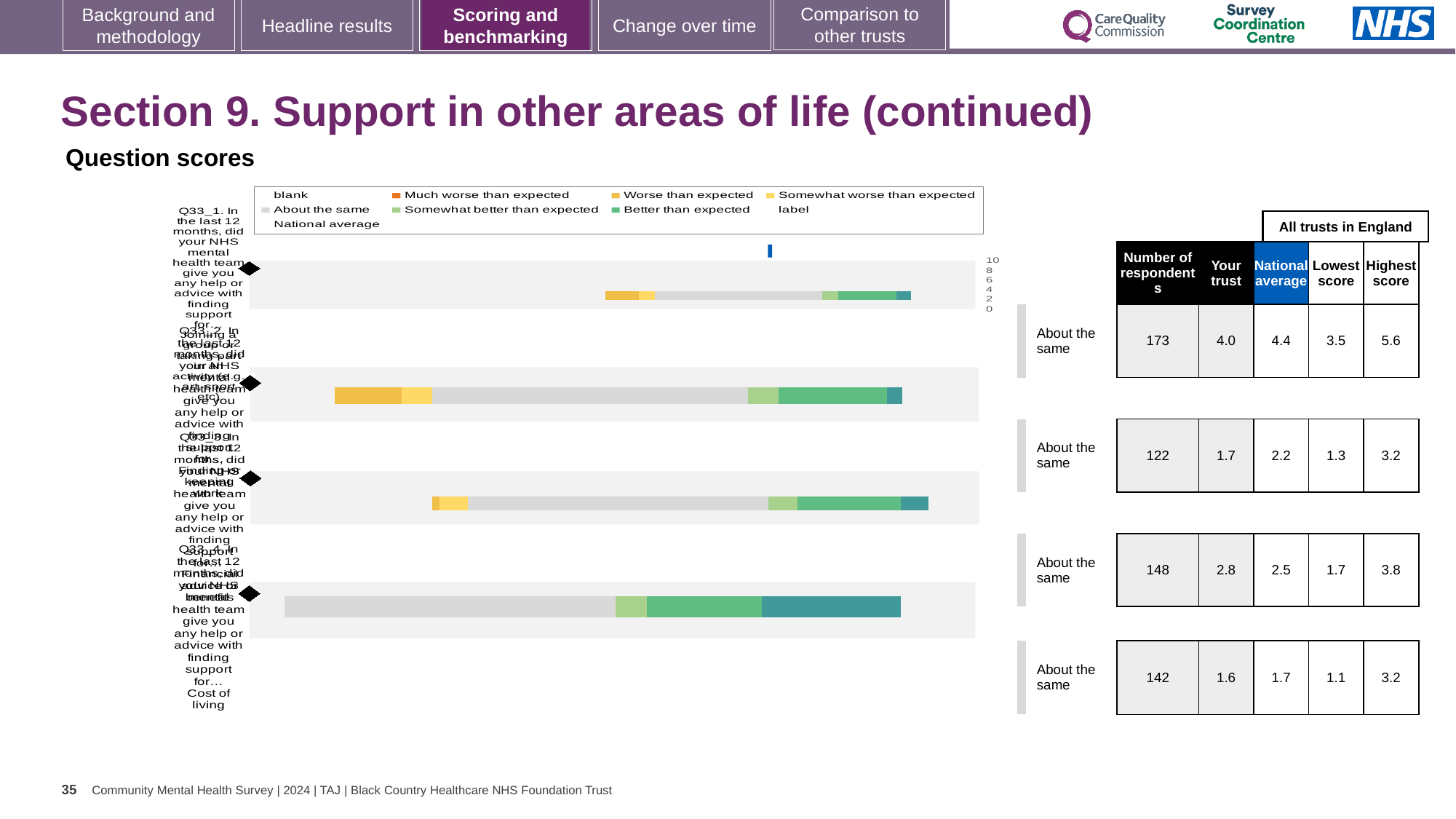
Which row of the table has the highest number of respondents? the first row (173) In the first row of the table, what is the difference between the national average and the 'Your trust' score? 0.4 What kind of chart is shown on the slide? bar chart What is the 'Your trust' score in the first row of the table? 4.0 What benchmark label is shown next to each of the four bars? About the same What is the lowest score in the fourth row of the table? 1.1 What is the number of respondents shown in the first row of the table? 173 How many question bars are plotted in the chart? 4 What is the national average in the second row of the table? 2.2 Which row of the table has the lowest 'Your trust' score? the fourth row (1.6) What is the highest score in the third row of the table? 3.8 In the third row of the table, which is larger: the 'Your trust' score or the national average? Your trust (2.8)